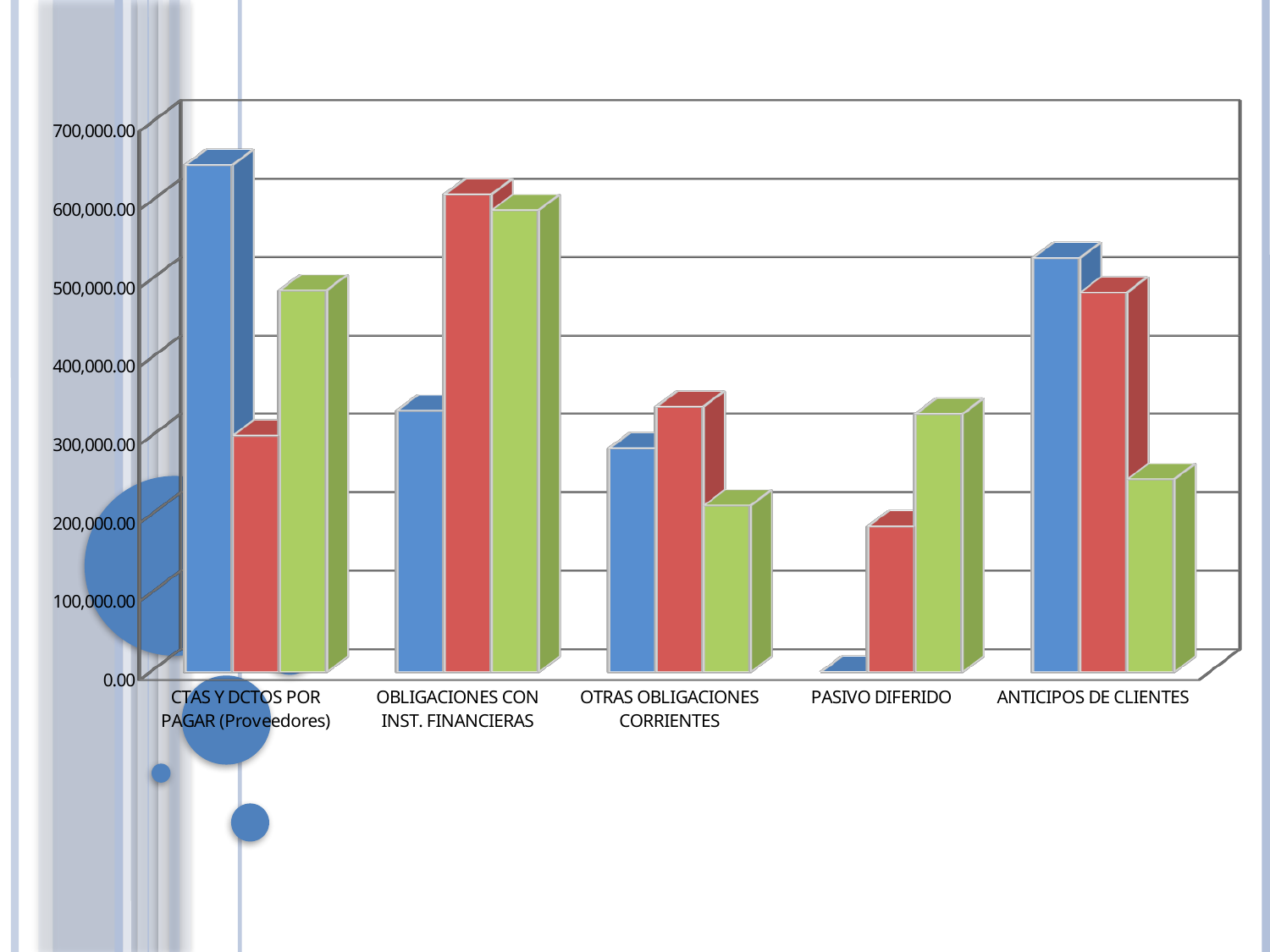
What kind of chart is shown on the slide? bar chart Among the red bars, which category has the highest value? OBLIGACIONES CON INST. FINANCIERAS Among the blue bars, which category has the highest value? CTAS Y DCTOS POR PAGAR (Proveedores) For OTRAS OBLIGACIONES CORRIENTES, which bar is larger, the red bar or the green bar? red bar How many categories are shown along the x axis of the chart? 5 Is the value of the red bar for CTAS Y DCTOS POR PAGAR (Proveedores) greater or less than 400,000.00? less Among the blue bars, which category has the lowest value? PASIVO DIFERIDO Is the value of the blue bar for CTAS Y DCTOS POR PAGAR (Proveedores) greater or less than 600,000.00? greater For PASIVO DIFERIDO, which bar is larger, the blue bar or the green bar? green bar How many bars are plotted for each category in the chart? 3 Is the value of the green bar for OTRAS OBLIGACIONES CORRIENTES greater or less than 300,000.00? less